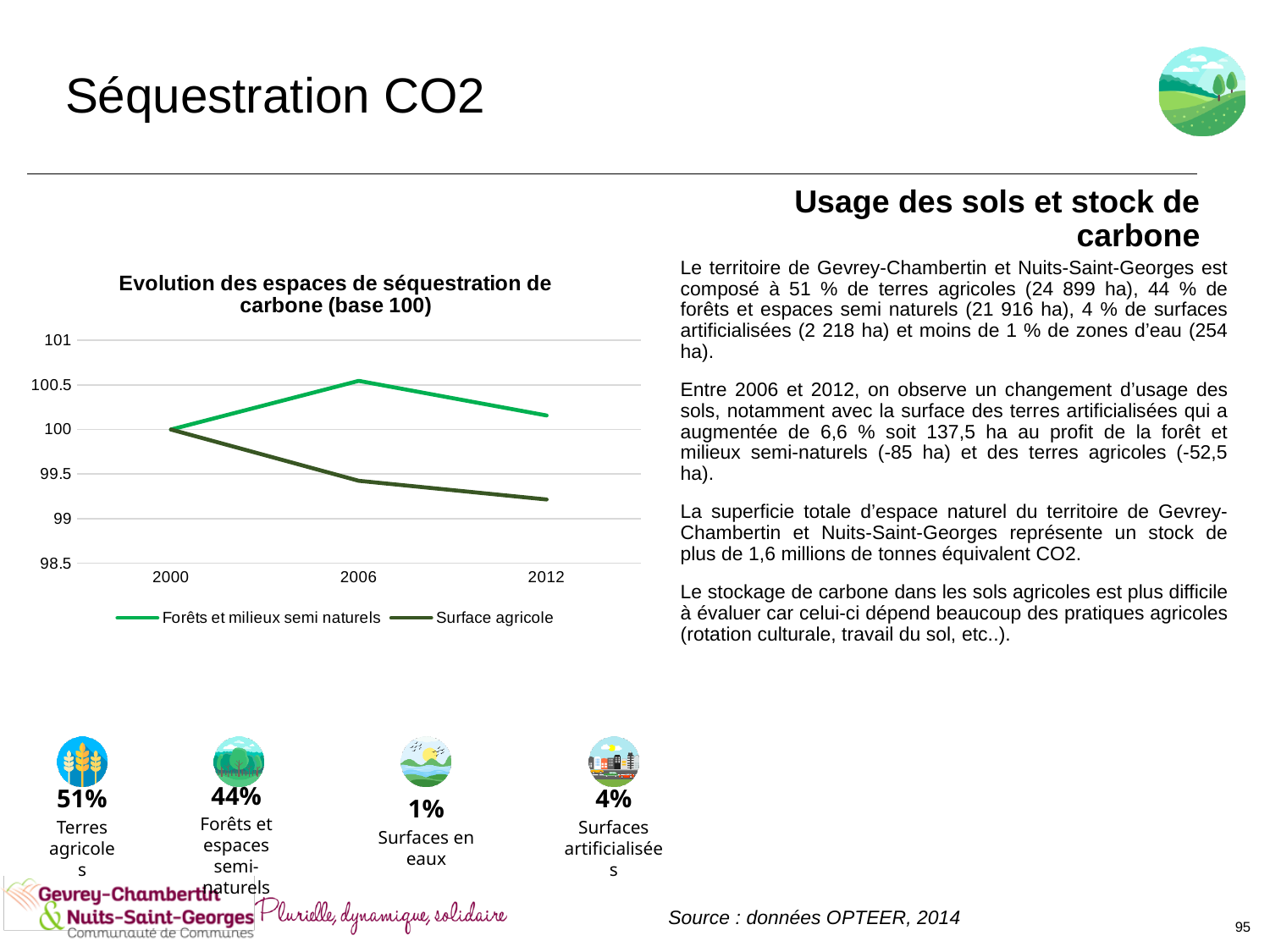
Is the value for Surface agricole in 2006 greater or less than 100? less How many years are shown on the x axis of the chart? 3 Which two series are listed in the chart's legend? Forêts et milieux semi naturels; Surface agricole Does the Surface agricole series rise or fall from 2000 to 2012? Fall In 2012, which series has the higher value: Forêts et milieux semi naturels or Surface agricole? Forêts et milieux semi naturels What is the title of the chart on the slide? Evolution des espaces de séquestration de carbone (base 100) What is the value for Forêts et milieux semi naturels in 2000? 100 Is the value for Surface agricole in 2012 greater or less than 99.5? less How many series does the chart's legend list? 2 What is the value for Surface agricole in 2000? 100 What kind of chart is shown on the slide? Line chart Is the value for Forêts et milieux semi naturels in 2006 greater or less than 100? greater